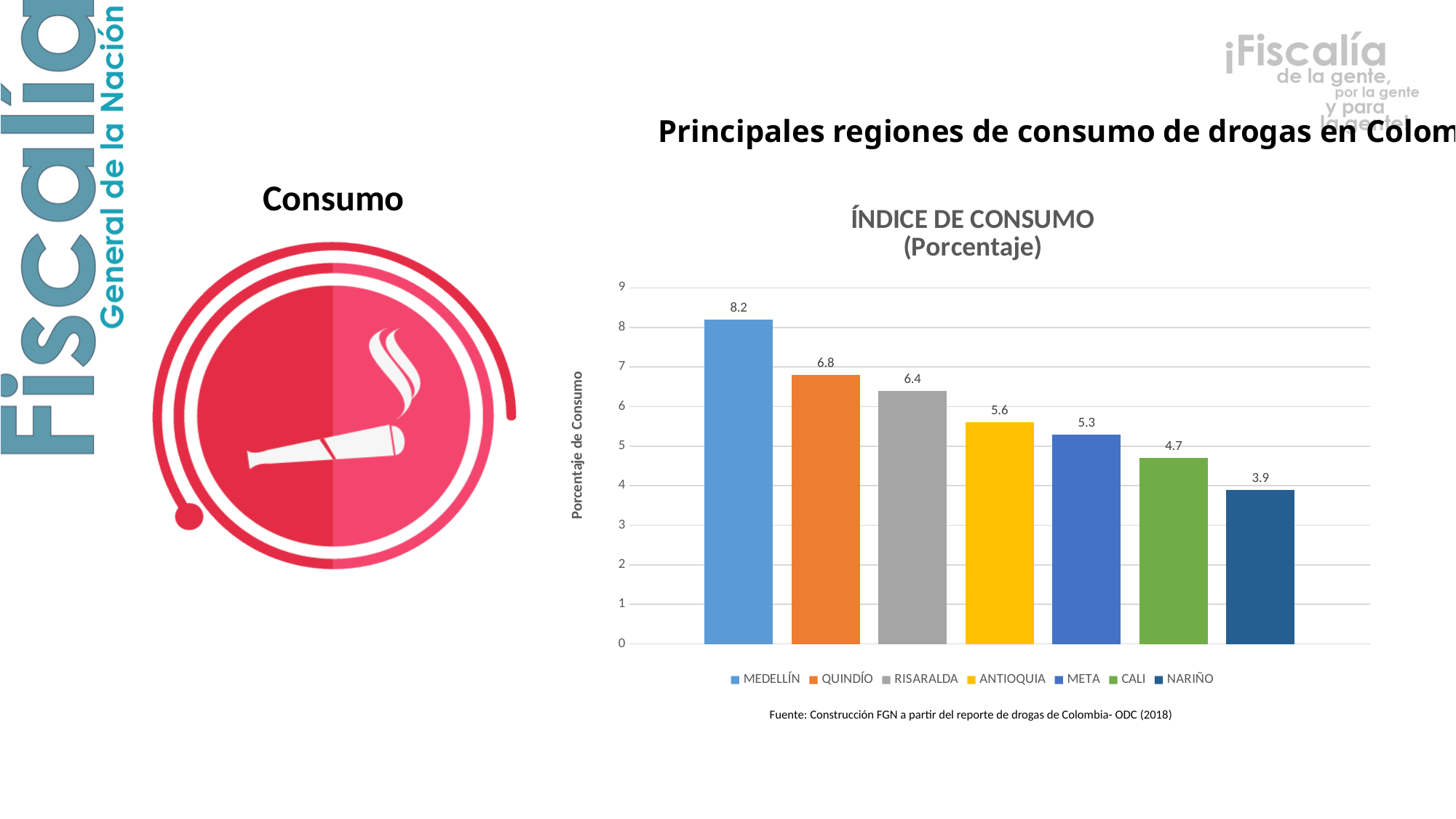
Which region has the lowest value in the ÍNDICE DE CONSUMO chart? NARIÑO Which has a larger value, RISARALDA or ANTIOQUIA? RISARALDA What kind of chart is the ÍNDICE DE CONSUMO chart? bar chart What is the difference between the values for MEDELLÍN and QUINDÍO? 1.4 What is the value for MEDELLÍN in the ÍNDICE DE CONSUMO chart? 8.2 What is the value for NARIÑO in the ÍNDICE DE CONSUMO chart? 3.9 What is the difference between the values for META and CALI? 0.6 How many regions are shown in the ÍNDICE DE CONSUMO chart? 7 What is the label of the vertical axis in the ÍNDICE DE CONSUMO chart? Porcentaje de Consumo Is the value for CALI greater or less than 5? less What is the value for ANTIOQUIA in the ÍNDICE DE CONSUMO chart? 5.6 Which region has the highest value in the ÍNDICE DE CONSUMO chart? MEDELLÍN